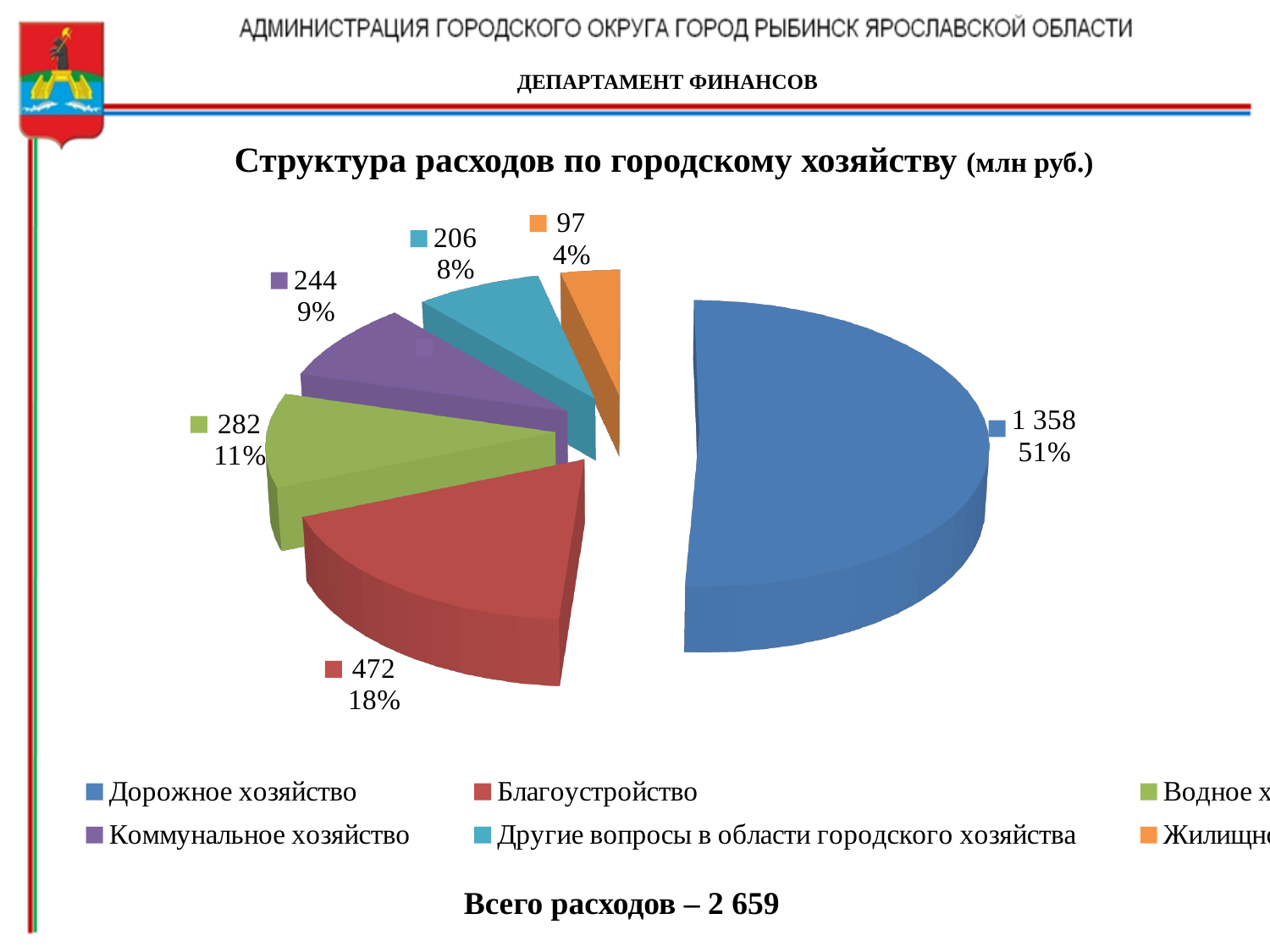
What share of the pie does Благоустройство take? 18% What share of the pie does Дорожное хозяйство take? 51% What is the value for Благоустройство? 472 How many slices does the pie chart have? 6 What is the value for Коммунальное хозяйство? 244 What kind of chart is shown on the slide? Pie chart Which category has the largest slice of the pie? Дорожное хозяйство Which is larger, the value for Коммунальное хозяйство or for Другие вопросы в области городского хозяйства? Коммунальное хозяйство What is the smallest value shown on the pie chart? 97 What is the value for Дорожное хозяйство? 1 358 What is the difference between the values for Дорожное хозяйство and Благоустройство? 886 What share of the pie does Другие вопросы в области городского хозяйства take? 8%